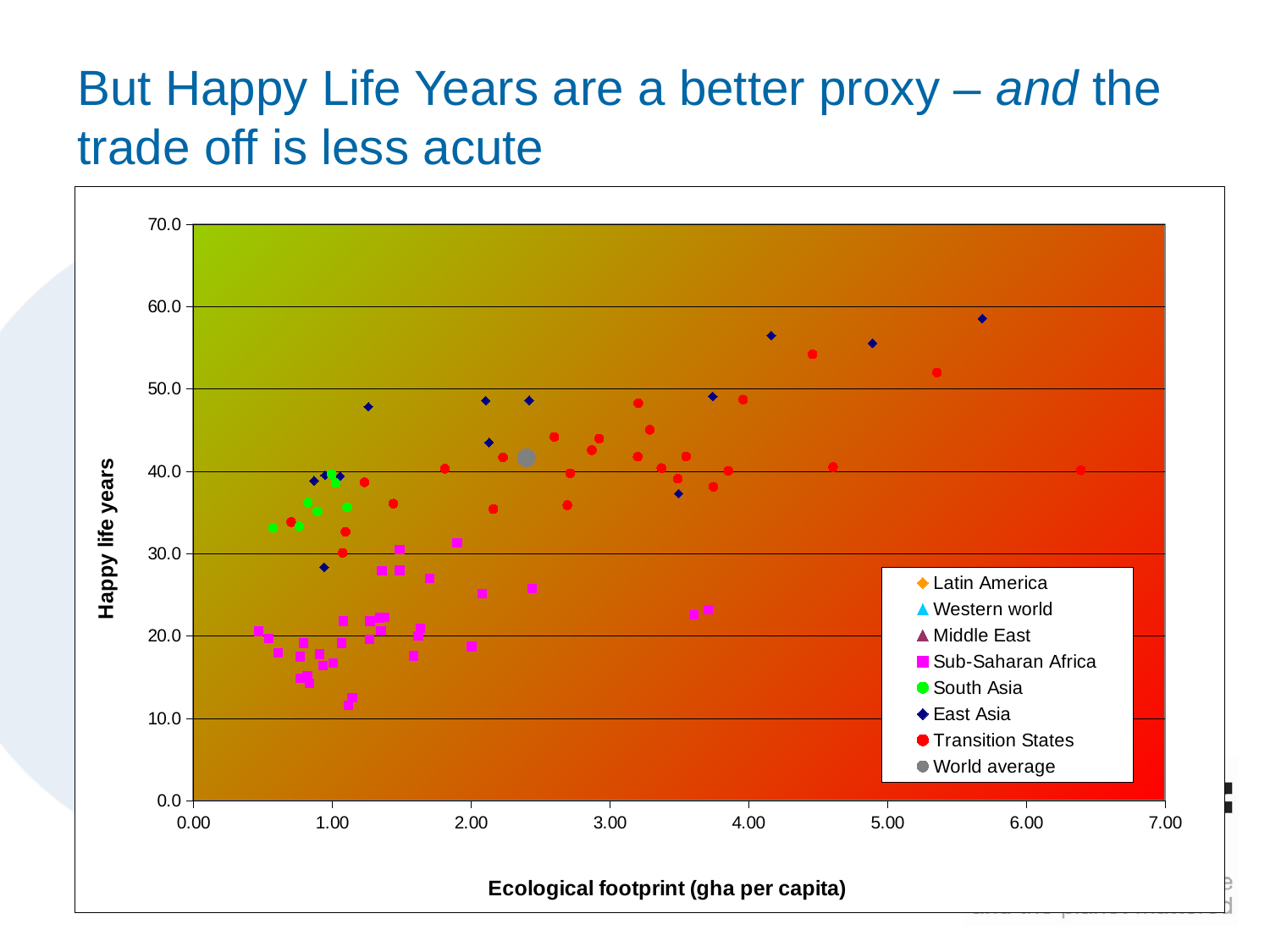
Is the highest East Asia point's happy life years value greater or less than 50.0? greater Which series generally has the lowest happy life years values on the chart? Sub-Saharan Africa What is the title of the y axis? Happy life years Is the Transition States point with the largest ecological footprint greater or less than 6.00 gha per capita? greater What is the maximum value shown on the y axis? 70.0 What is the title of the x axis? Ecological footprint (gha per capita) What kind of chart is shown on the slide? scatter chart Is the ecological footprint of the World average point greater or less than 3.00? less How many series does the legend list? 8 Do happy life years generally rise or fall as ecological footprint increases along the x axis? rise